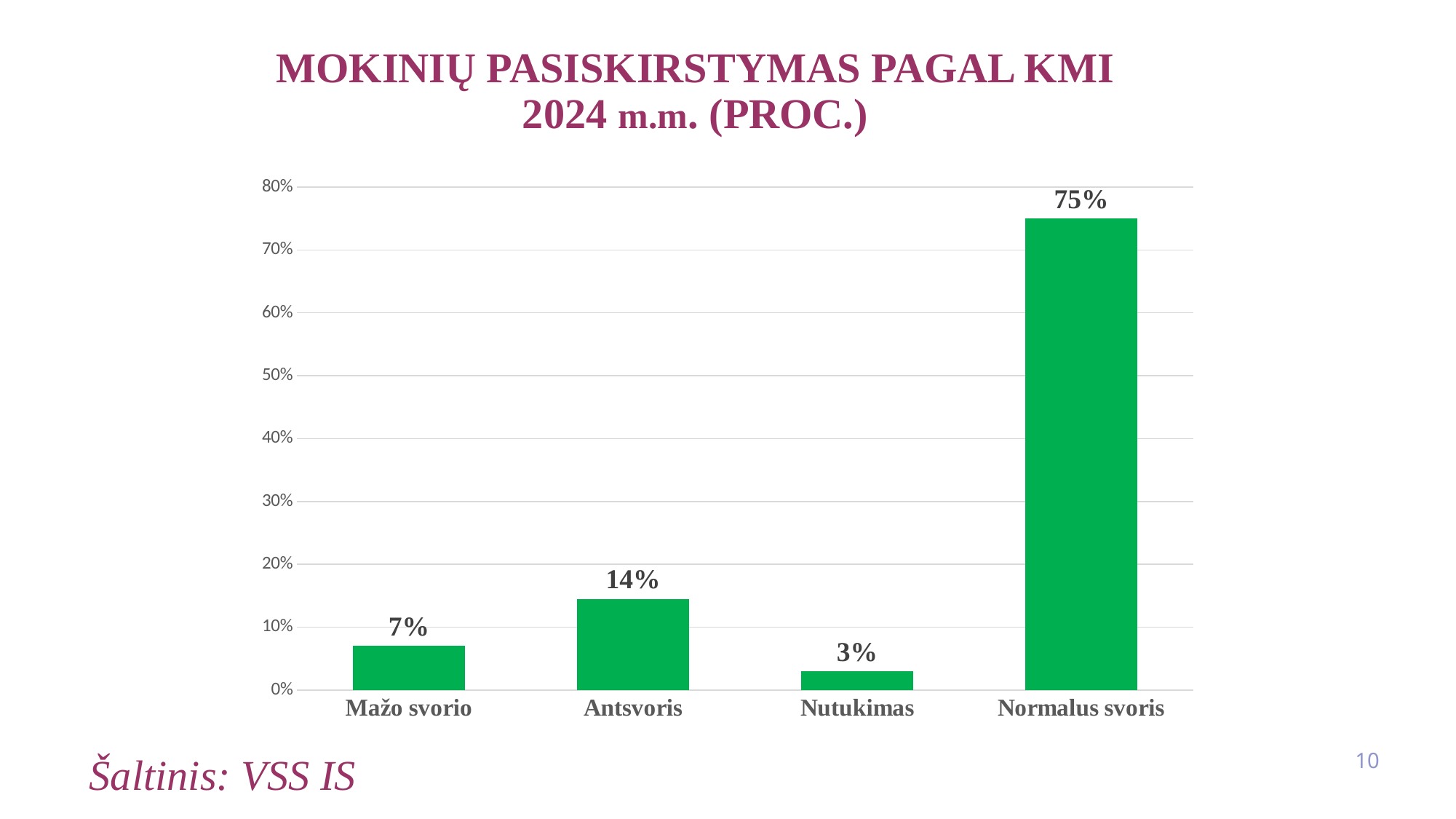
Which is larger, the value for Mažo svorio or the value for Nutukimas? Mažo svorio What is the value for Normalus svoris? 75% What kind of chart is shown on the slide? Bar chart How many categories are shown on the x axis? 4 Which category has the lowest value? Nutukimas What is the value for Nutukimas? 3% What is the title of the chart? MOKINIŲ PASISKIRSTYMAS PAGAL KMI 2024 m.m. (PROC.) What is the difference between the values for Normalus svoris and Antsvoris? 61% What is the value for Mažo svorio? 7% What is the difference between the values for Antsvoris and Mažo svorio? 7% Which category has the highest value? Normalus svoris What is the value for Antsvoris? 14%